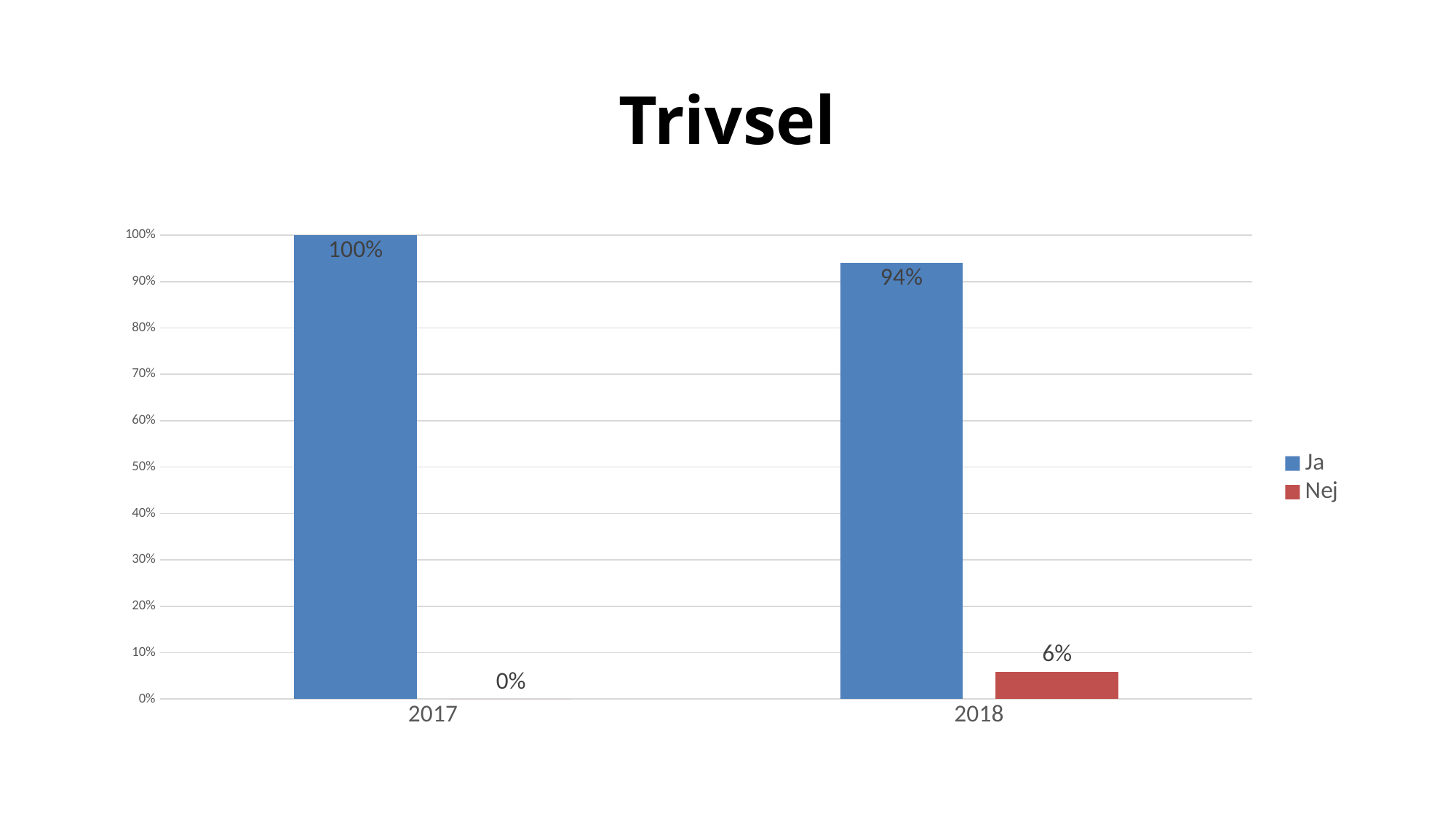
What is the value for Ja in 2017? 100% In which year is the Nej value lowest? 2017 What is the value for Nej in 2018? 6% How many series does the legend list? 2 How many years are shown on the x axis? 2 Which is larger in 2018, Ja or Nej? Ja Does the Ja value rise or fall from 2017 to 2018? Fall What is the value for Ja in 2018? 94% What is the difference between the Ja values for 2017 and 2018? 6% What kind of chart is shown on the slide? Bar chart In which year is the Ja value highest? 2017 What is the value for Nej in 2017? 0%